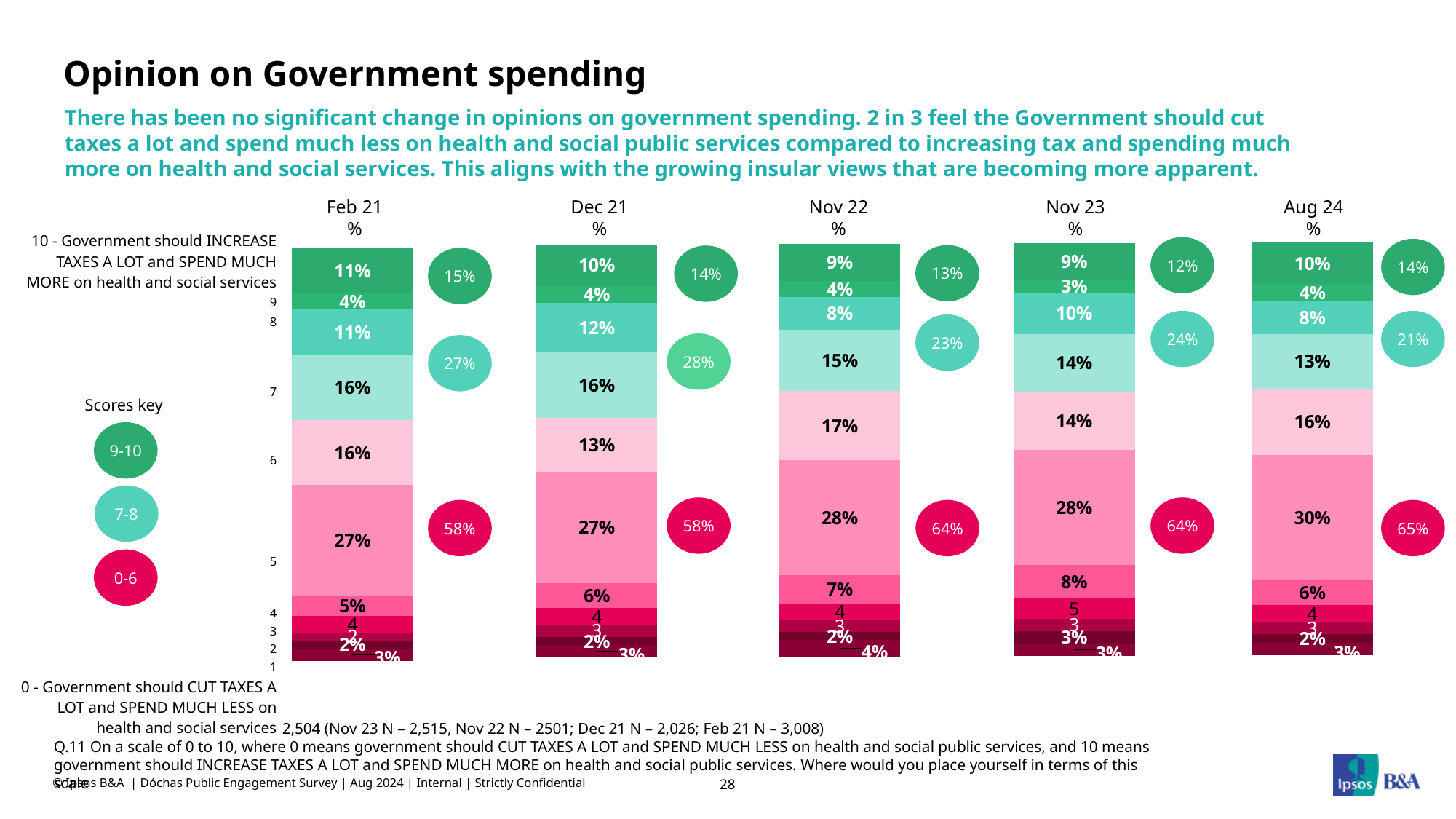
How many survey waves (bars) are shown in the chart? 5 Does the combined 0-6 share rise or fall across the waves from Feb 21 to Aug 24? Rises Which is larger: the share scoring 7 in Feb 21 or the share scoring 7 in Aug 24? Feb 21 Which survey wave has the highest combined 7-8 share? Dec 21 What percentage gave a score of 8 in Nov 23? 10% By how many percentage points did the combined 0-6 share change from Feb 21 (58%) to Aug 24 (65%)? 7 percentage points What is the combined 9-10 share shown in the circle for Dec 21? 14% What is the combined 0-6 share shown in the circle for Nov 22? 64% What kind of chart is shown on the slide? Stacked bar chart Which survey wave has the highest combined 0-6 share? Aug 24 Which survey wave has the lowest combined 9-10 share? Nov 23 What percentage gave a score of 5 in Aug 24? 30%